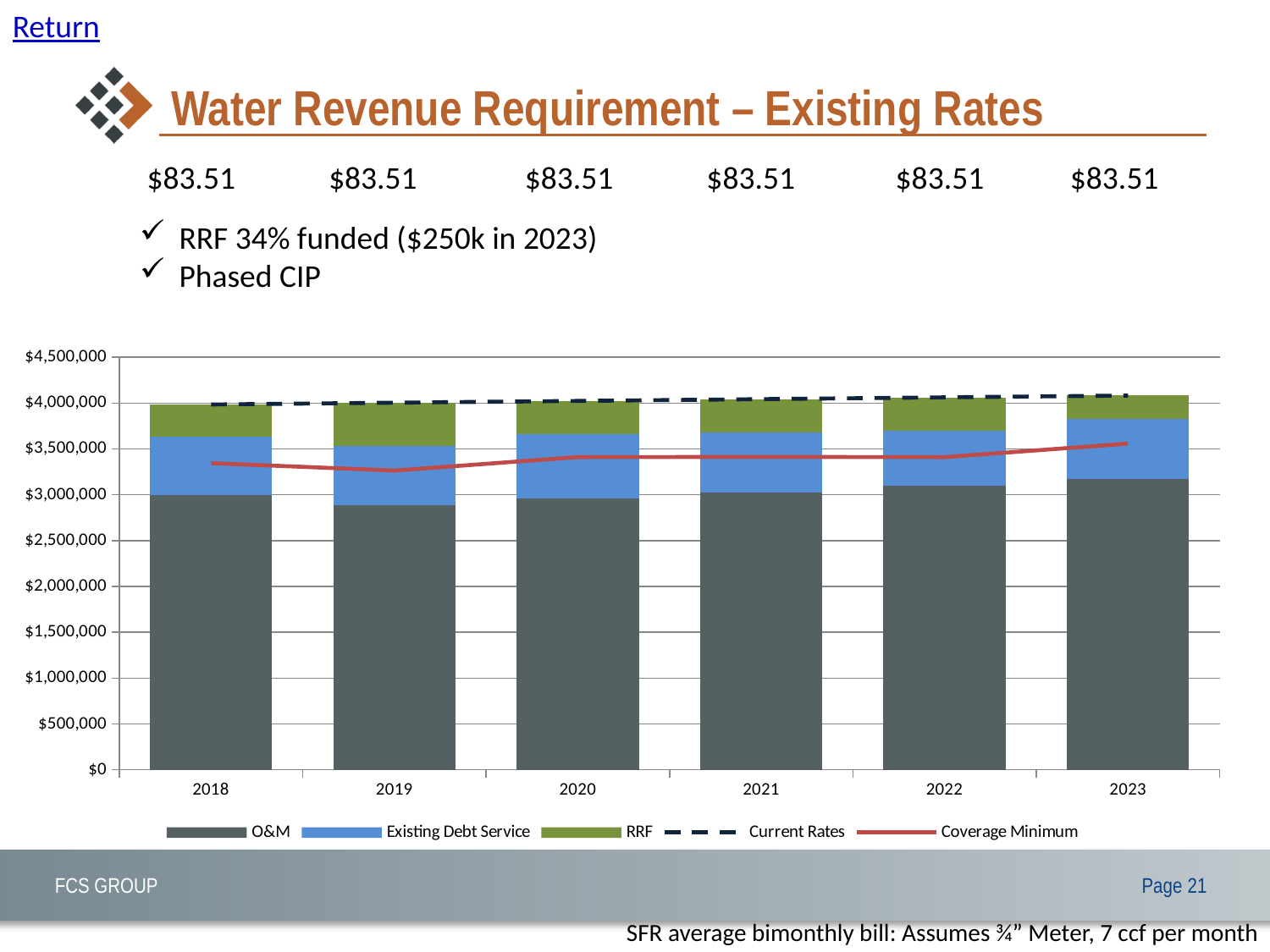
Is the O&M value for 2019 greater or less than $3,000,000? less What kind of chart is shown on the slide? Stacked bar chart with line series Is the O&M value for 2023 greater or less than $3,000,000? greater Which series is drawn as a dashed line in the chart? Current Rates How many series does the chart legend list? 5 Is the total stacked bar for 2023 greater or less than $4,000,000? greater Which year has the highest O&M value? 2023 Does the Coverage Minimum line rise or fall from 2019 to 2023? rise Which is larger, the Coverage Minimum value for 2023 or for 2019? 2023 How many years are shown on the x axis of the chart? 6 Which year has the lowest O&M value? 2019